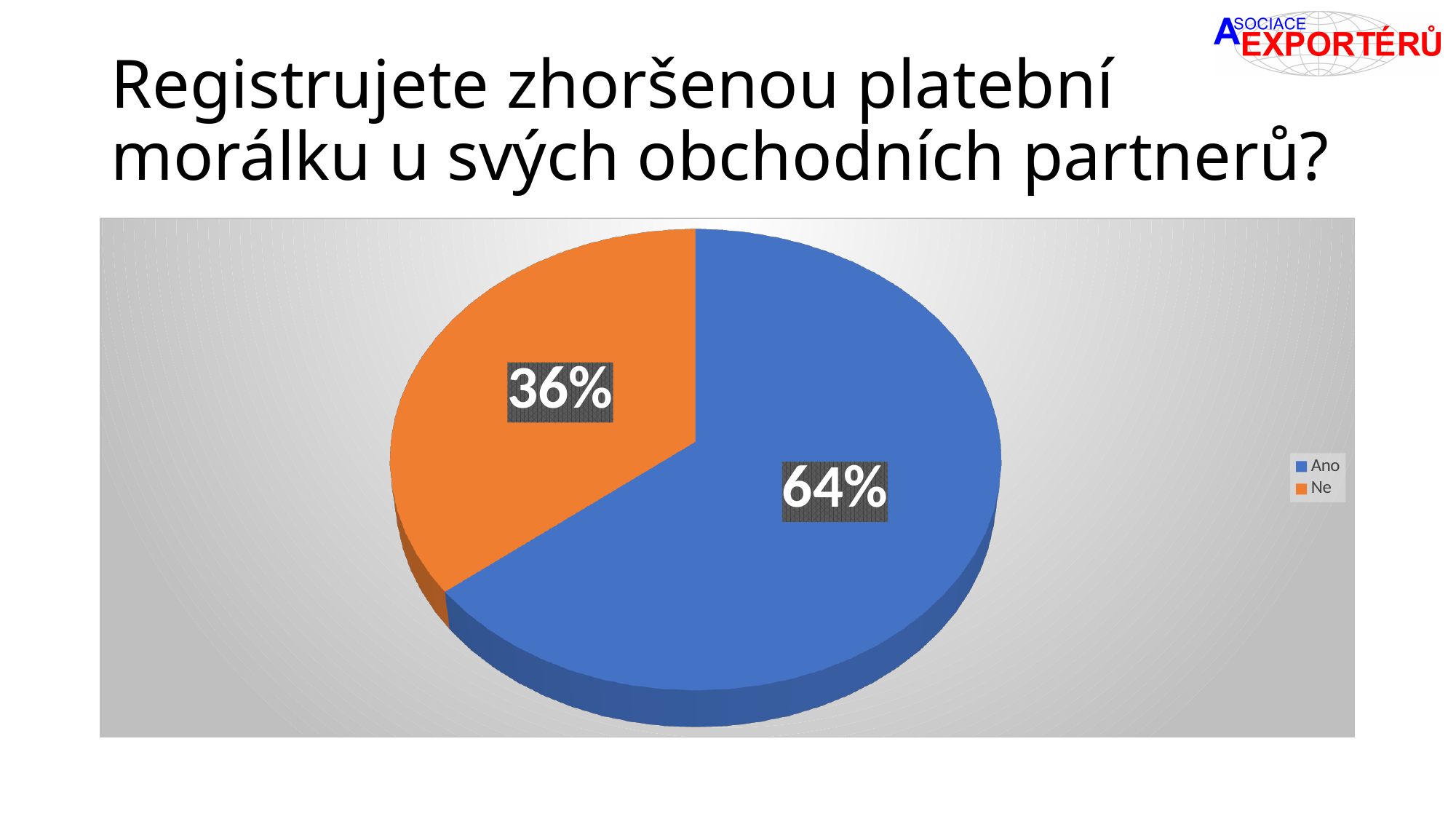
What share of the pie does the "Ne" slice represent? 36% Which is larger, the "Ano" slice or the "Ne" slice? Ano Which slice is the largest in the pie chart? Ano What colour is the "Ne" slice? orange What share of the pie does the "Ano" slice represent? 64% What kind of chart is shown on the slide? pie chart What colour is the "Ano" slice? blue How many slices does the pie chart have? 2 How many entries does the legend list? 2 What is the difference in percentage points between the "Ano" and "Ne" slices? 28 Which slice is the smallest in the pie chart? Ne